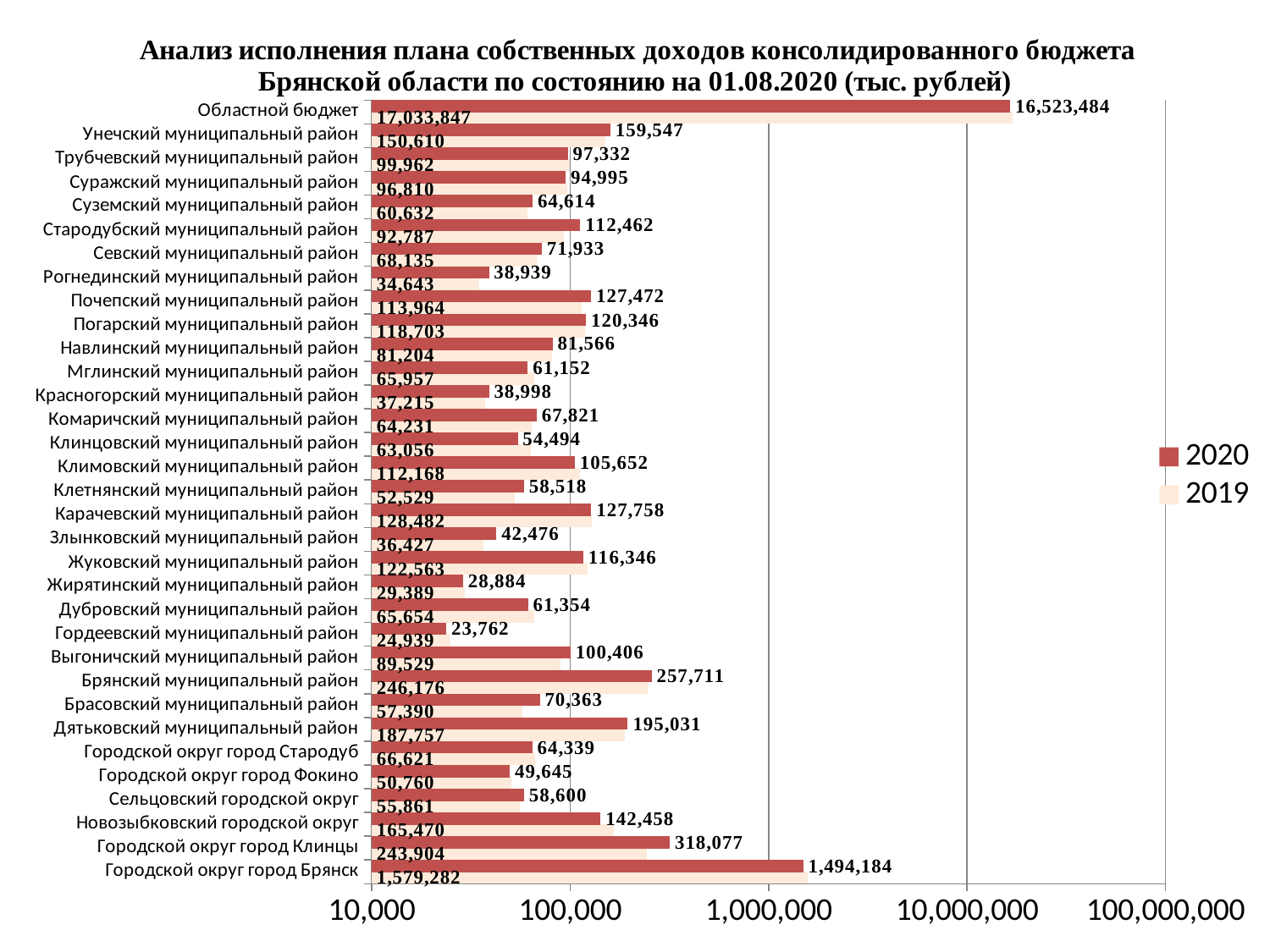
What kind of chart is shown on the slide? Bar chart Is the 2020 value for Городской округ город Брянск greater or less than 1,000,000? greater What is the 2020 value for Брянский муниципальный район? 257,711 Which category has the lowest 2020 value? Гордеевский муниципальный район How many series does the legend list? 2 Which is larger for Новозыбковский городской округ: the 2020 value or the 2019 value? 2019 How many categories are shown on the chart? 33 What is the 2019 value for Областной бюджет? 17,033,847 Which category has the highest 2020 value? Областной бюджет What is the difference between the 2020 and 2019 values for Стародубский муниципальный район? 19,675 What is the 2019 value for Новозыбковский городской округ? 165,470 What is the 2020 value for Городской округ город Клинцы? 318,077